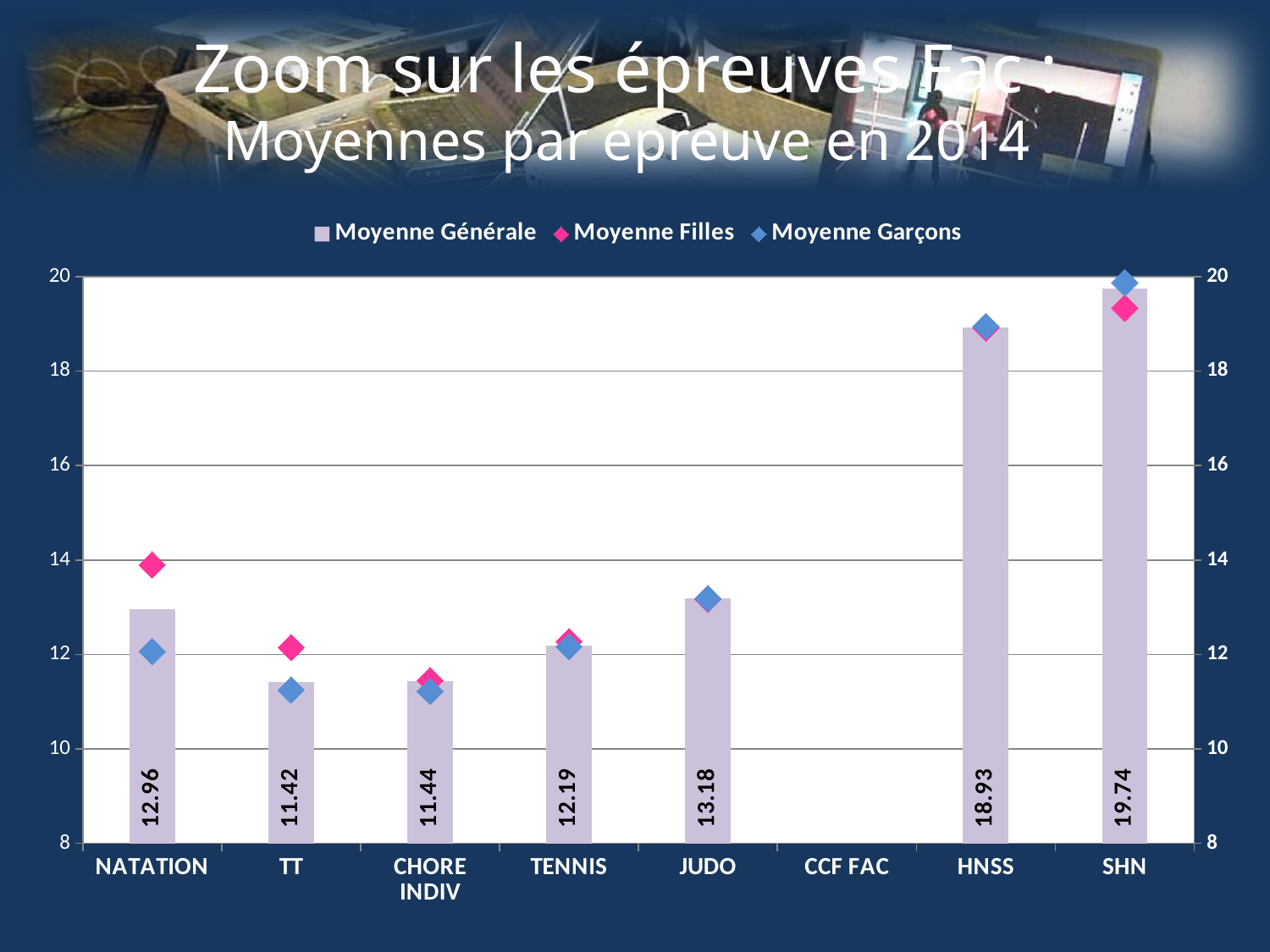
Is the Moyenne Filles value for NATATION greater or less than 12? greater What is the difference between the Moyenne Générale values for SHN and HNSS? 0.81 Which category has the highest Moyenne Générale bar? SHN Is the Moyenne Garçons value for SHN greater or less than 18? greater How many series does the legend list? 3 Which category has the lowest Moyenne Générale bar? TT How many categories are shown on the x axis? 8 What is the Moyenne Générale value for HNSS? 18.93 Which series is shown with pink diamond markers? Moyenne Filles Which has a larger Moyenne Générale, NATATION or JUDO? JUDO What is the difference between the Moyenne Générale values for JUDO and TENNIS? 0.99 What is the Moyenne Générale value for NATATION? 12.96